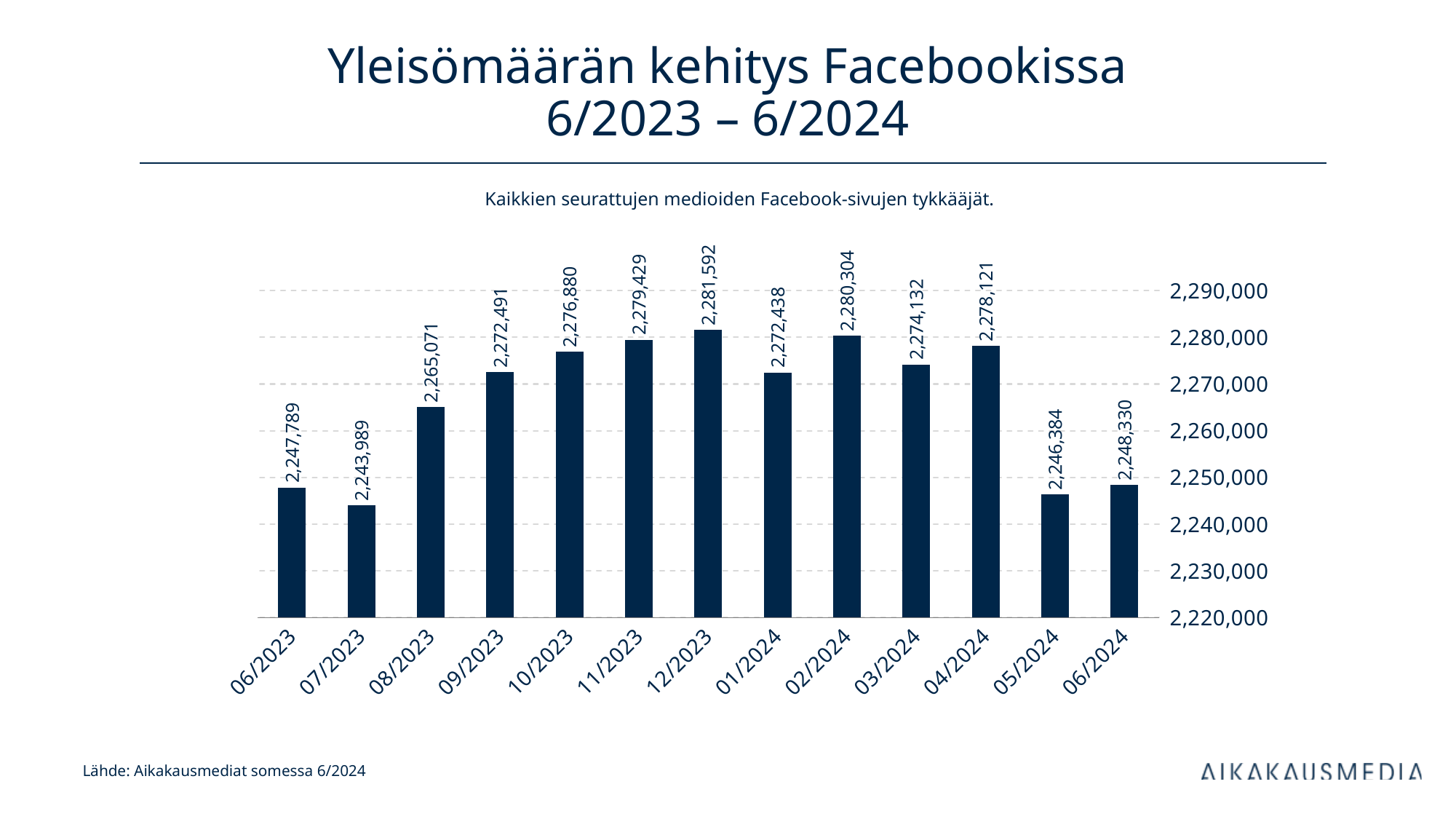
What is the difference between the values for 06/2024 and 06/2023? 541 What is the difference between the values for 12/2023 and 07/2023? 37,603 Which is larger, the value for 02/2024 or the value for 04/2024? 02/2024 Which month has the lowest value? 07/2023 How many months are shown on the x axis? 13 Which month has the highest value? 12/2023 Do the values rise or fall from 06/2023 to 12/2023? rise What kind of chart is shown on the slide? bar chart What is the value for 06/2024? 2,248,330 Is the value for 05/2024 greater or less than 2,250,000? less What is the value for 07/2023? 2,243,989 What is the value for 12/2023? 2,281,592